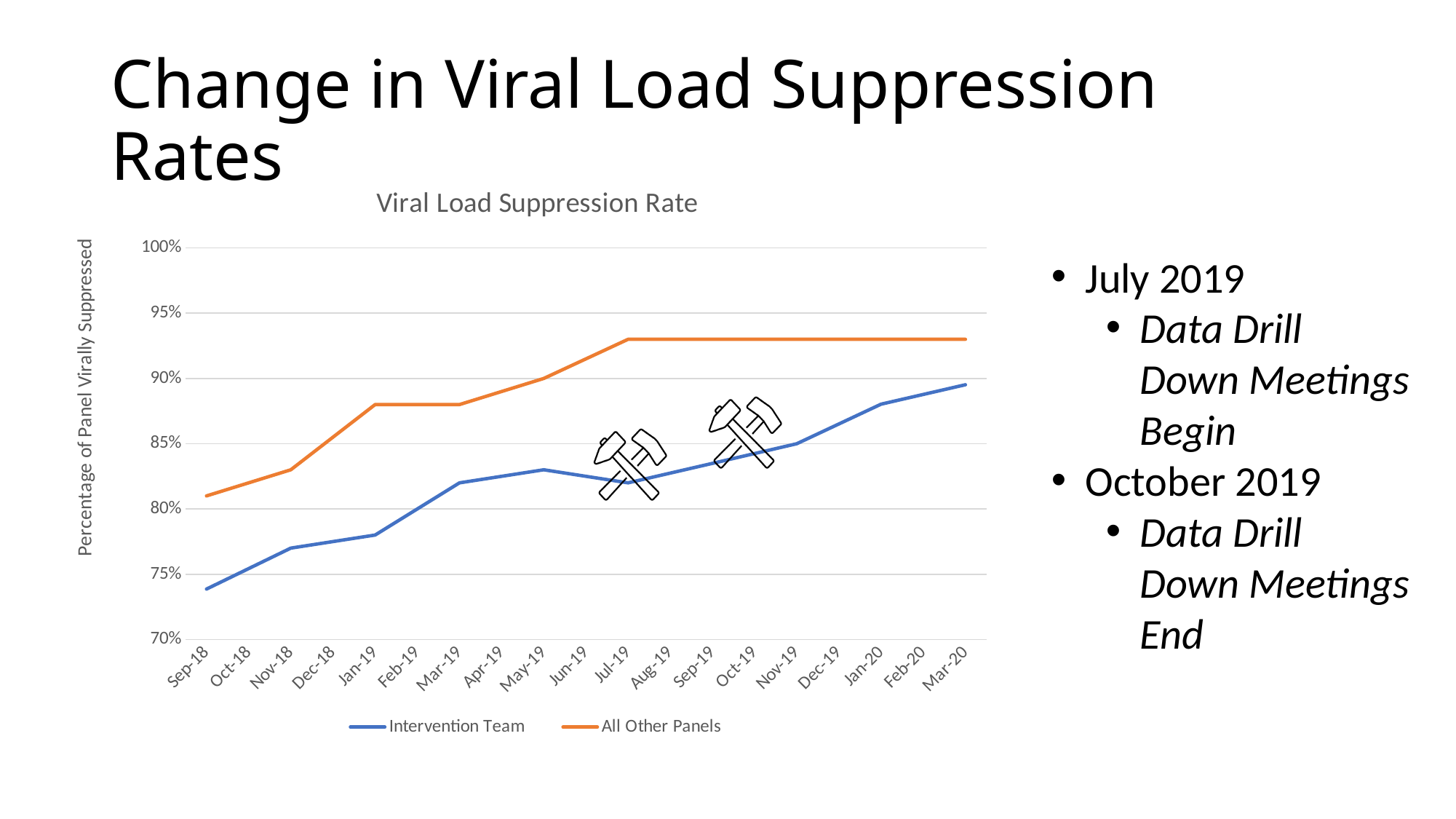
Does the Intervention Team series generally rise or fall from Sep-18 to Mar-20? rise Is the value for All Other Panels in Mar-20 greater or less than 90%? greater What kind of chart is shown on the slide? line chart Is the value for Intervention Team in Sep-18 greater or less than 75%? less In which month does the Intervention Team series reach its lowest value? Sep-18 How many months are plotted along the x axis of the chart? 19 How many series does the chart legend list? 2 What is the label of the vertical axis of the chart? Percentage of Panel Virally Suppressed What is the title of the chart? Viral Load Suppression Rate Which series has the higher value in Sep-18, Intervention Team or All Other Panels? All Other Panels Is the value for All Other Panels in Sep-18 greater or less than 85%? less